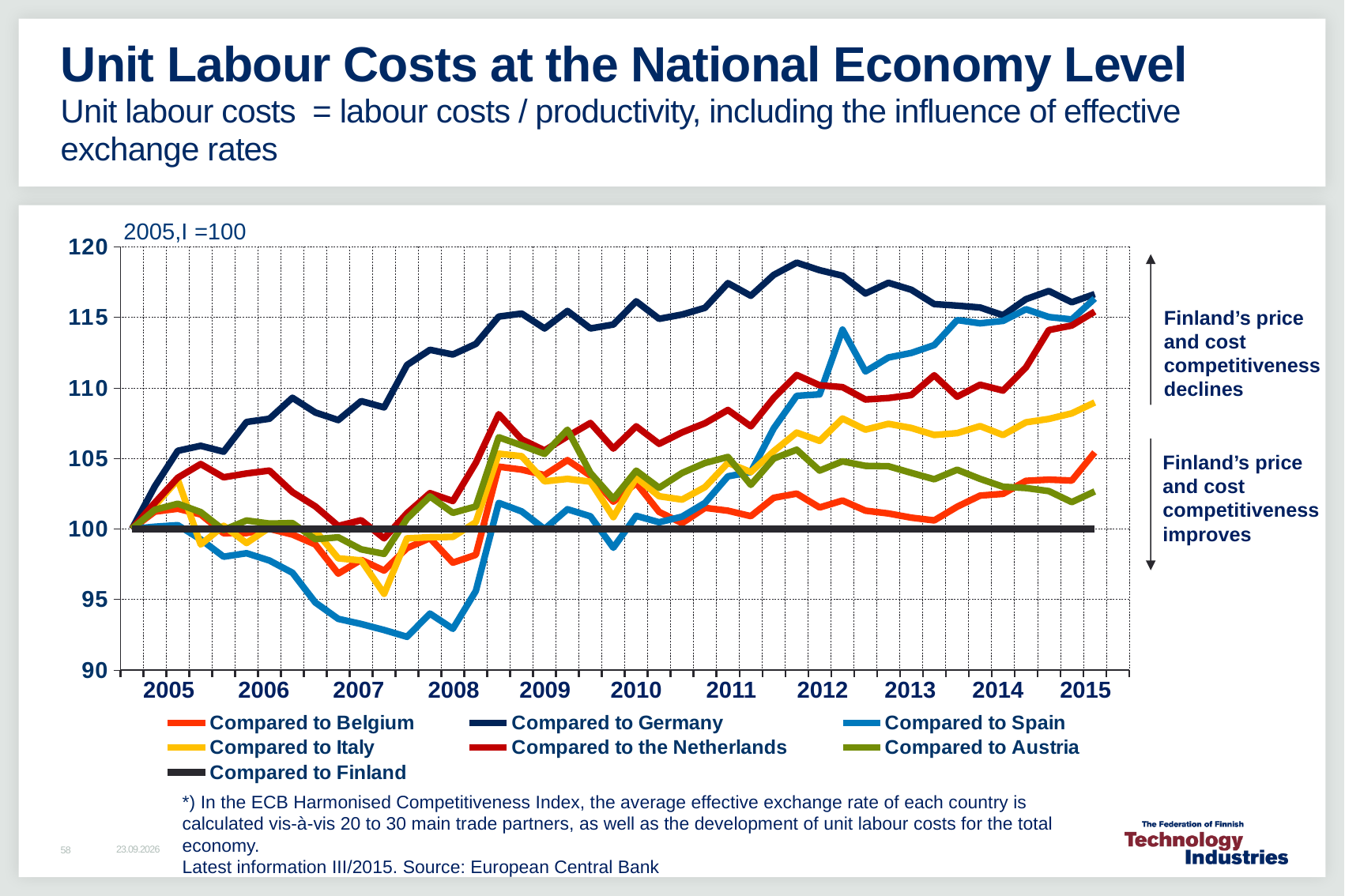
Which series is the lowest line in 2007? Compared to Spain What kind of chart is shown on the slide? line chart What constant value does the Compared to Finland line hold across the whole period? 100 How many series does the legend list? 7 Is the value for Compared to the Netherlands in 2015 greater or less than 110? greater Which is larger in 2012, the value for Compared to Germany or the value for Compared to Belgium? Compared to Germany Does the Compared to Spain line rise or fall between 2005 and 2007? fall What base-period note is printed above the y axis of the chart? 2005,I =100 Is the value for Compared to Spain in 2007 greater or less than 95? less Which series is the highest line in 2012? Compared to Germany How many year labels are shown on the x axis? 11 Is the value for Compared to Germany in 2012 greater or less than 115? greater